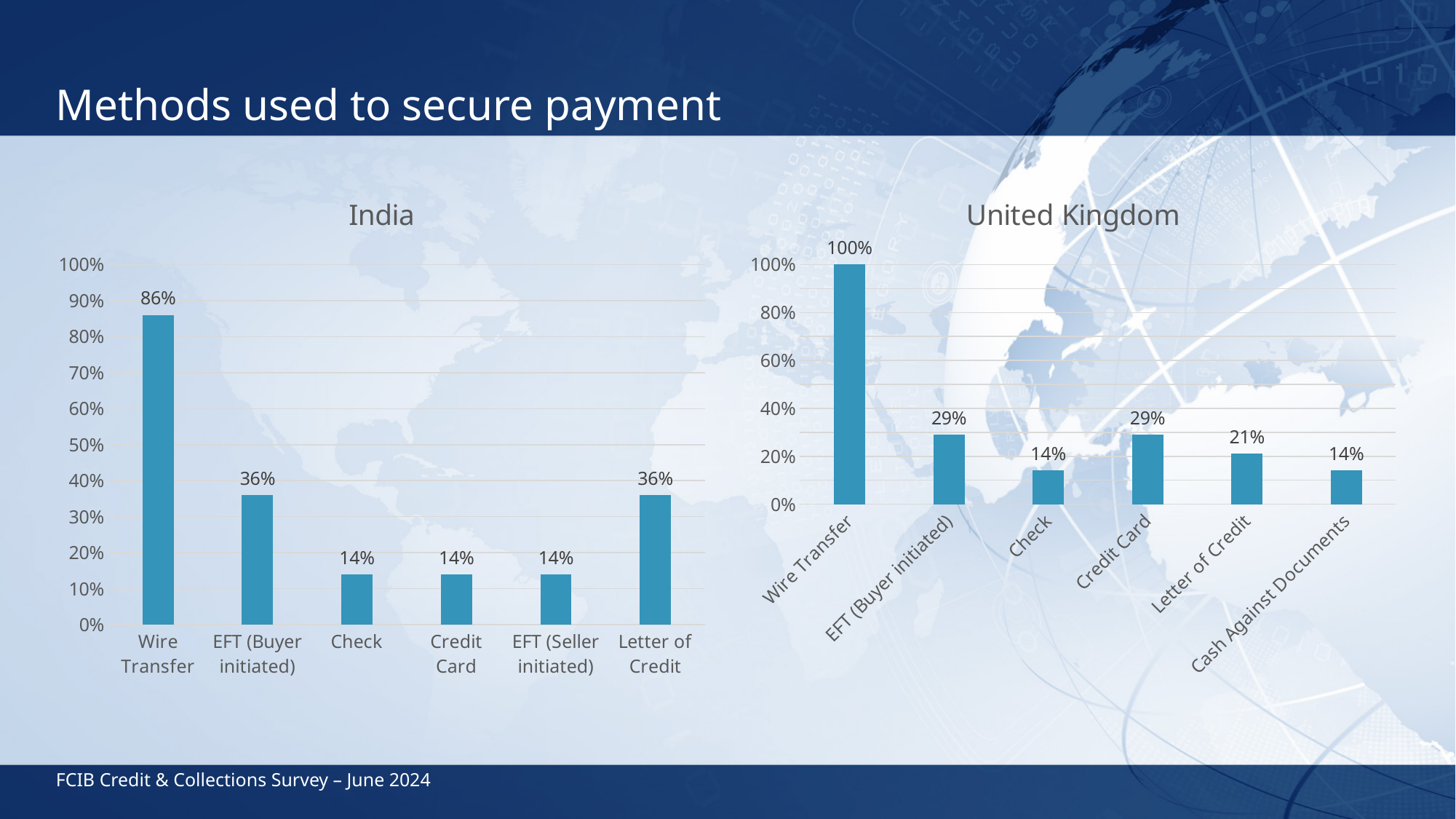
In the India chart, which is larger: EFT (Buyer initiated) or Check? EFT (Buyer initiated) In the India chart, what is the value for Wire Transfer? 86% In the India chart, which method has the highest value? Wire Transfer What kind of chart is the United Kingdom chart? Bar chart In the United Kingdom chart, what is the value for Letter of Credit? 21% In the United Kingdom chart, what is the difference between Wire Transfer and EFT (Buyer initiated)? 71% In the United Kingdom chart, which method has the highest value? Wire Transfer In the India chart, what is the difference between Wire Transfer and Letter of Credit? 50% How many categories are shown in the India chart? 6 In the United Kingdom chart, which is larger: Credit Card or Letter of Credit? Credit Card How many categories are shown in the United Kingdom chart? 6 In the India chart, what is the value for EFT (Seller initiated)? 14%